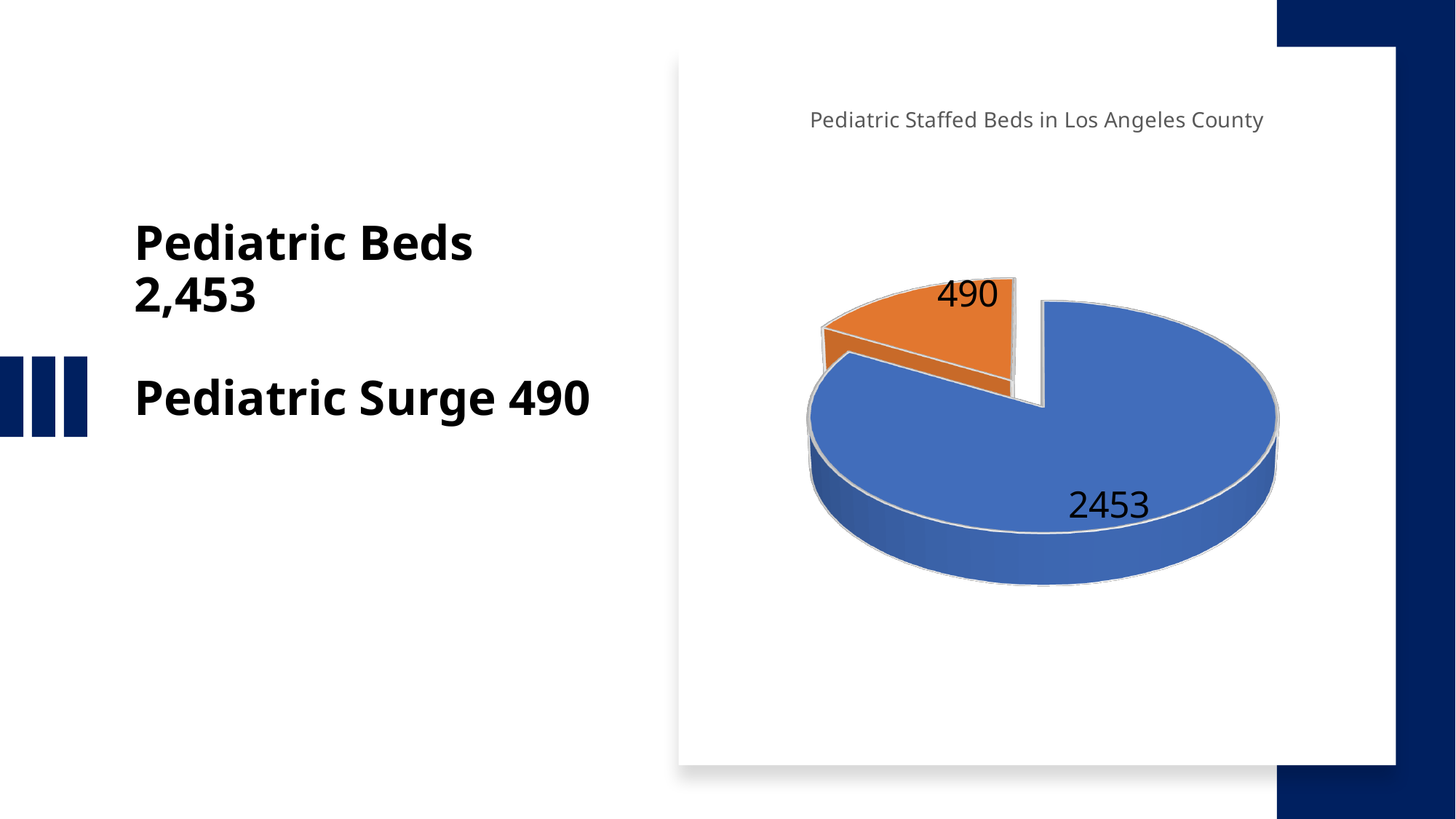
Is the blue slice (2453) or the orange slice (490) larger? the blue slice (2453) What kind of chart is shown on the slide? pie chart What colour is the slice representing the Pediatric Surge value of 490? orange Which slice of the pie chart is the smallest? the orange slice (490) What is the difference between the two values shown on the pie chart, 2453 and 490? 1963 How many slices does the pie chart have? 2 What is the total of the two values shown on the pie chart? 2943 What value is labelled on the blue slice of the pie chart? 2453 What is the title of the chart? Pediatric Staffed Beds in Los Angeles County Which slice of the pie chart is the largest? the blue slice (2453) What value is labelled on the orange slice of the pie chart? 490